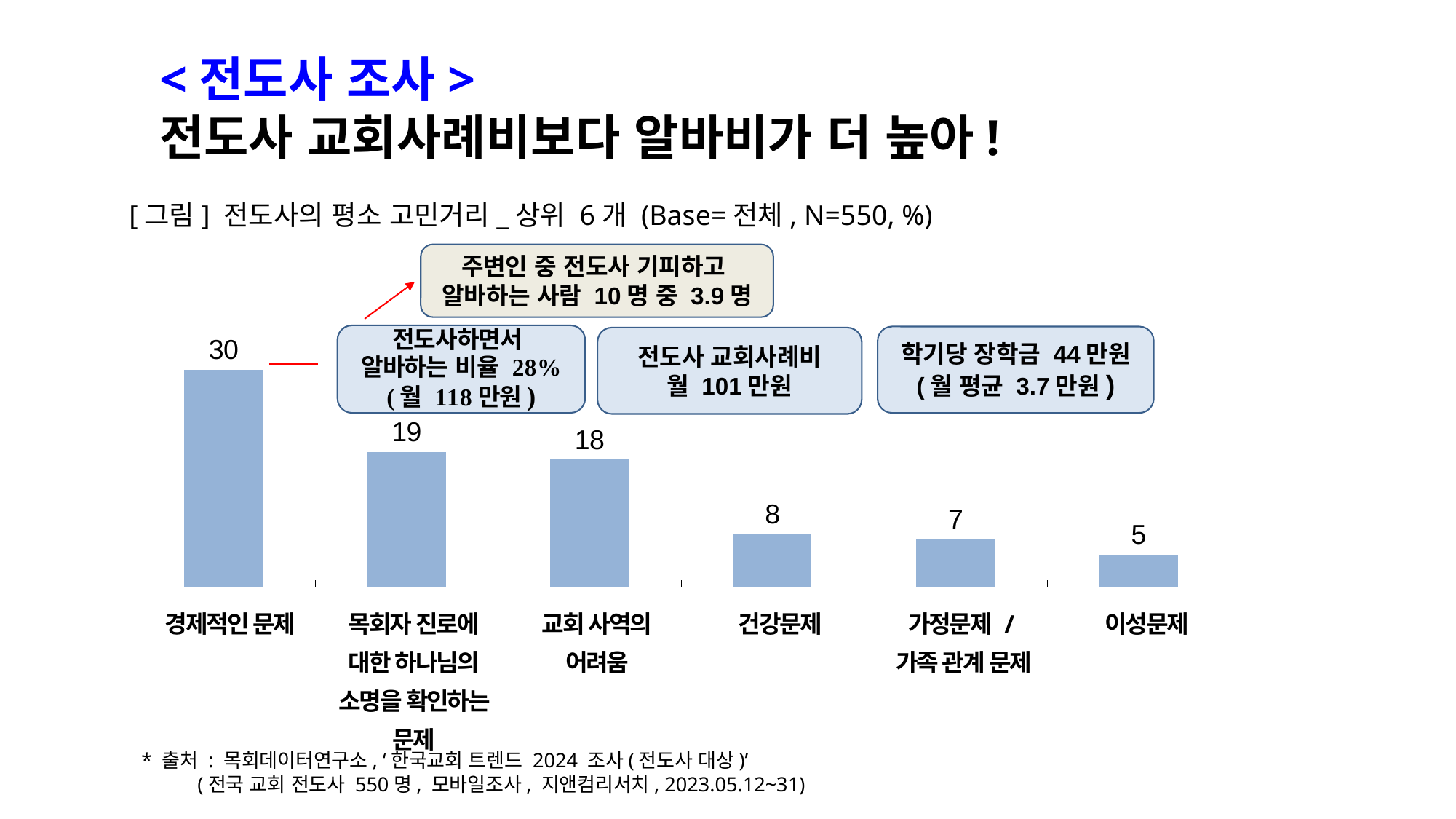
Which category has the lowest value? 이성문제 Which category has the highest value? 경제적인 문제 What is the value for 경제적인 문제? 30 How many categories are shown in the chart? 6 What kind of chart is shown on the slide? bar chart Which is larger, the value for 교회 사역의 어려움 or the value for 건강문제? 교회 사역의 어려움 Do the values rise or fall from left to right along the x axis? fall What is the difference between the values for 건강문제 and 가정문제 / 가족 관계 문제? 1 What is the value for 교회 사역의 어려움? 18 What is the value for 건강문제? 8 What is the difference between the values for 경제적인 문제 and 목회자 진로에 대한 하나님의 소명을 확인하는 문제? 11 What is the value for 이성문제? 5